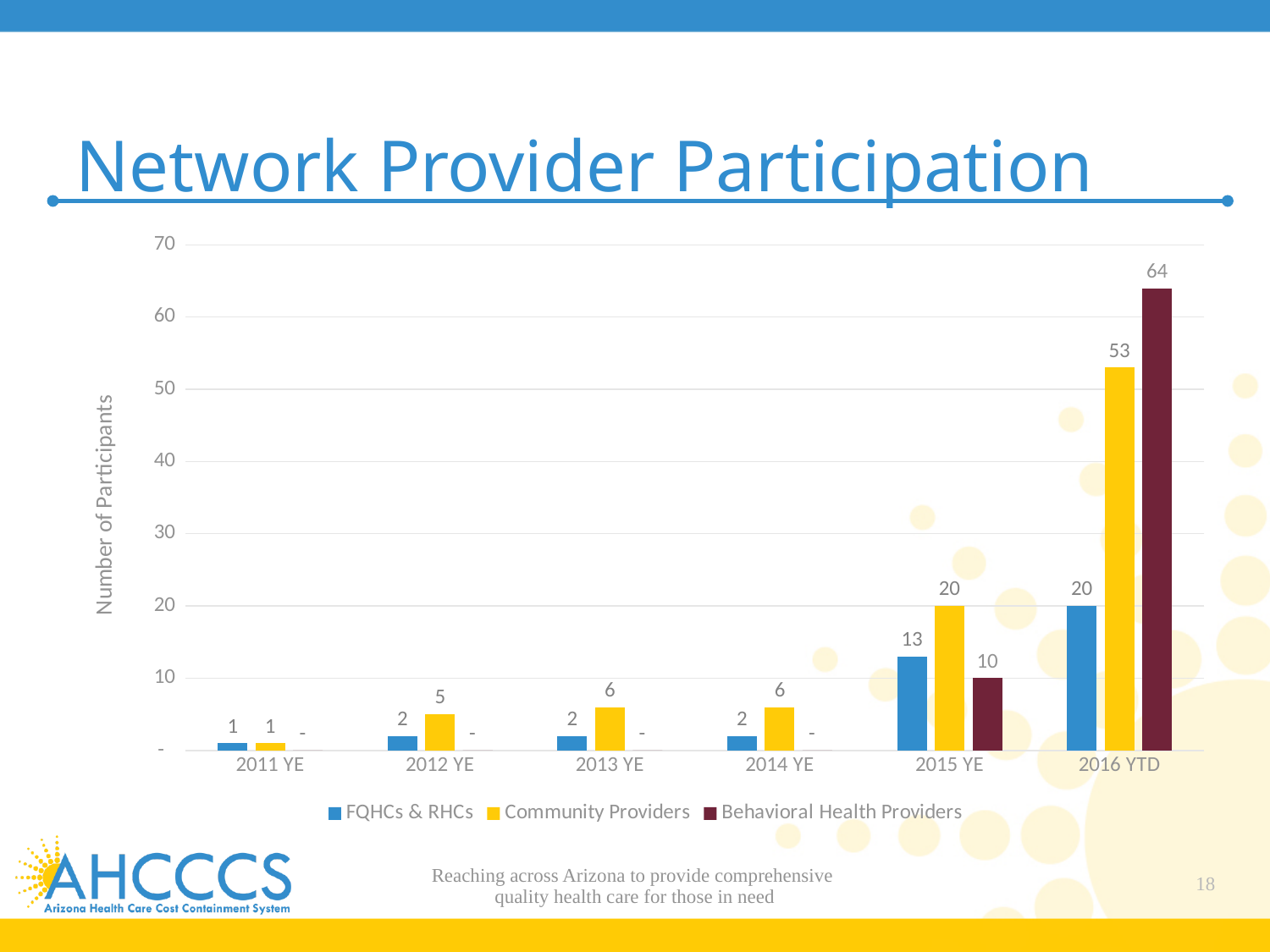
What is the value for FQHCs & RHCs in 2013 YE? 2 What is the value for Community Providers in 2015 YE? 20 What is the difference between Community Providers and FQHCs & RHCs in 2016 YTD? 33 What kind of chart is shown on the slide? Bar chart How many series does the legend list? 3 How many year categories are shown on the x axis? 6 What is the value for Behavioral Health Providers in 2016 YTD? 64 What is the label of the y axis? Number of Participants Do the Community Providers values rise or fall from 2011 YE to 2016 YTD? Rise In 2015 YE, which is larger: FQHCs & RHCs or Behavioral Health Providers? FQHCs & RHCs Which year has the highest value for Community Providers? 2016 YTD Which year has the lowest value for FQHCs & RHCs? 2011 YE